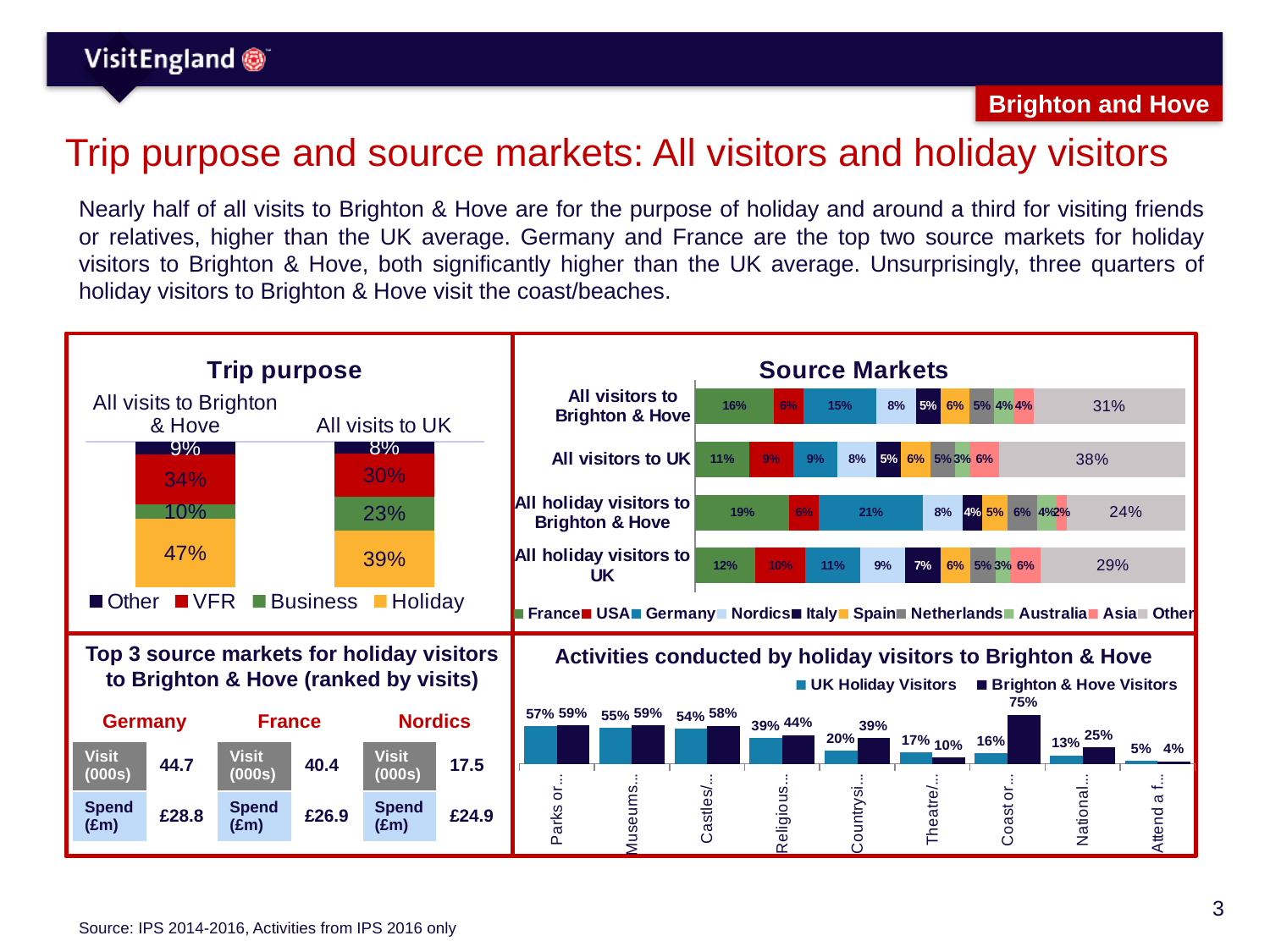
In the Trip purpose chart, what percentage of all visits to Brighton & Hove are for Holiday? 47% In the Activities conducted by holiday visitors to Brighton & Hove chart, which activity has the highest value for Brighton & Hove Visitors? Coast In the Source Markets chart, what percentage of all holiday visitors to Brighton & Hove come from Germany? 21% In the Source Markets chart, which is larger: the France share for all holiday visitors to Brighton & Hove or for all holiday visitors to UK? All holiday visitors to Brighton & Hove What kind of chart is the Source Markets chart? Stacked bar chart In the Source Markets chart, what percentage of all visitors to UK fall in the Other category? 38% In the Activities conducted by holiday visitors to Brighton & Hove chart, what percentage of Brighton & Hove Visitors visit the Coast? 75% In the Source Markets chart, how many source markets does the legend list? 10 In the Trip purpose chart, what percentage of all visits to UK are for Business? 23% In the Trip purpose chart, how many series does the legend list? 4 In the Trip purpose chart, what is the difference between the VFR share for all visits to Brighton & Hove and for all visits to UK? 4% In the Activities conducted by holiday visitors to Brighton & Hove chart, how many activity categories are shown? 9